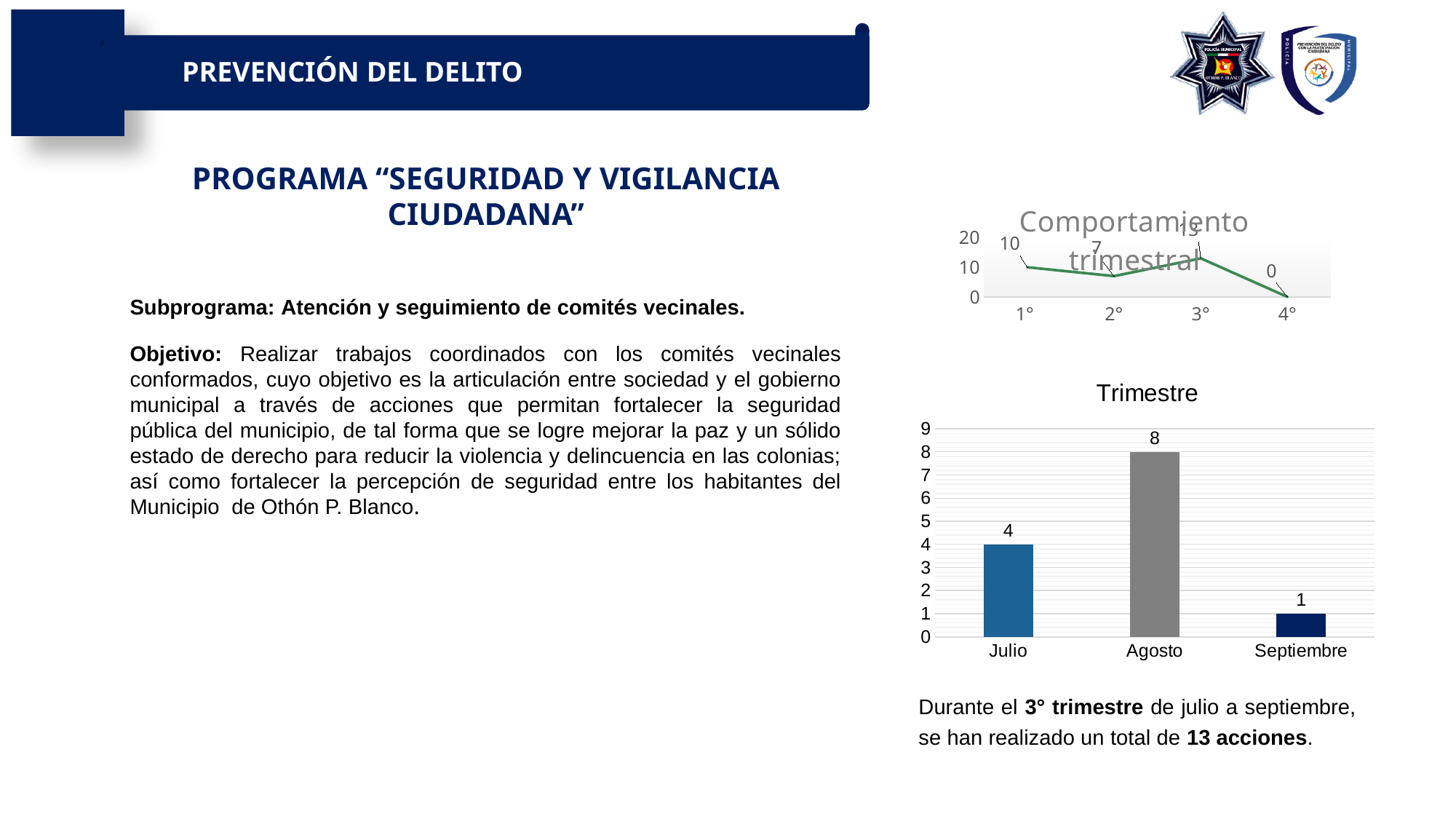
In the 'Trimestre' bar chart, which month has the highest value? Agosto In the 'Comportamiento trimestral' line chart, what is the value for 1°? 10 In the 'Trimestre' bar chart, what is the value for Julio? 4 In the 'Trimestre' bar chart, what is the value for Septiembre? 1 In the 'Trimestre' bar chart, how many categories are shown on the x axis? 3 In the 'Trimestre' bar chart, what is the difference between the values for Agosto and Julio? 4 In the 'Trimestre' bar chart, what is the value for Agosto? 8 In the 'Comportamiento trimestral' line chart, which is larger, the value for 1° or the value for 2°? 1° In the 'Comportamiento trimestral' line chart, what is the value for 4°? 0 What kind of chart is the 'Trimestre' chart? Bar chart What kind of chart is the 'Comportamiento trimestral' chart? Line chart In the 'Trimestre' bar chart, which month has the lowest value? Septiembre